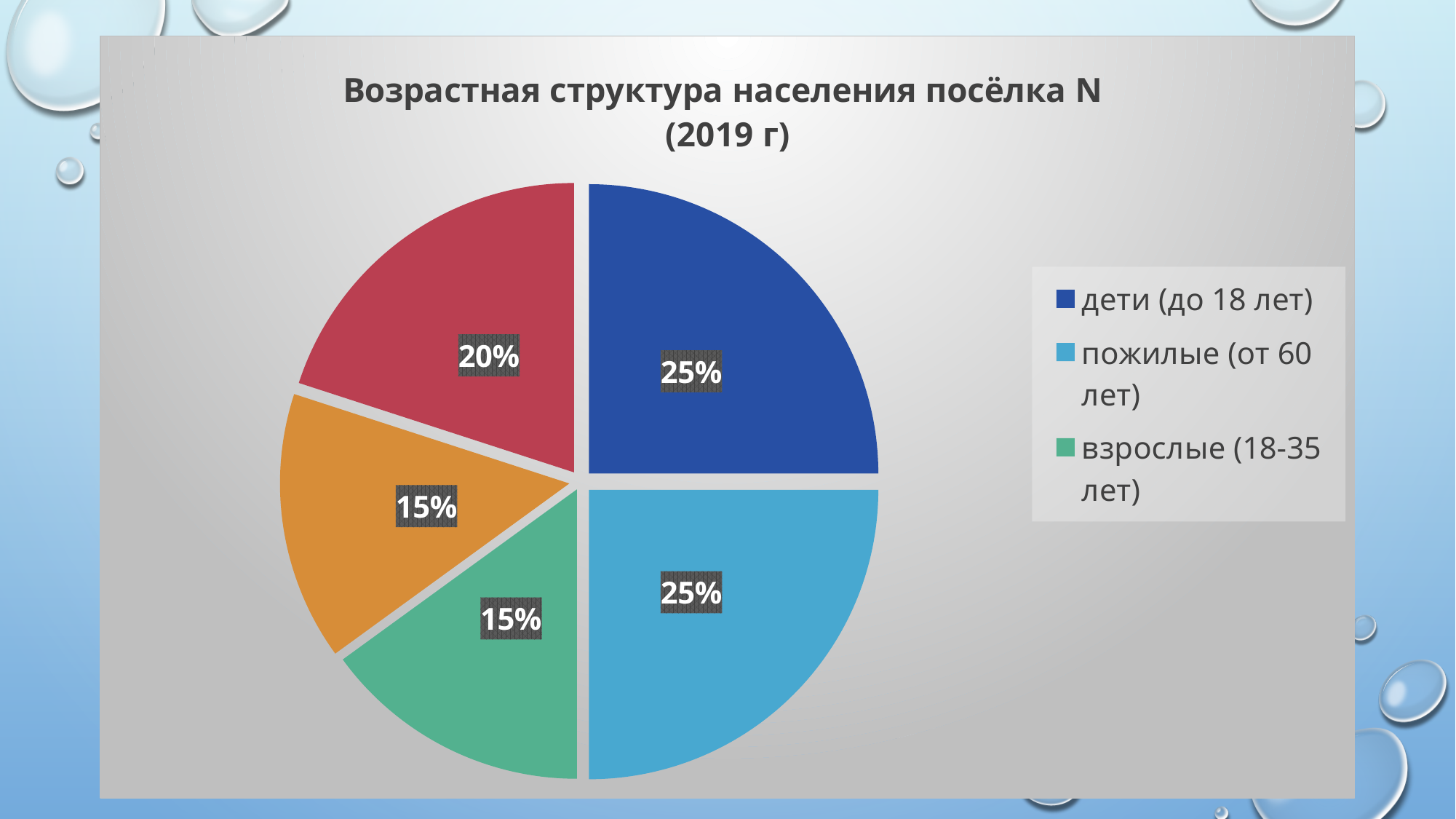
What is the difference between the red slice and the orange slice of the pie? 5% What share of the pie is labelled for взрослые (18-35 лет)? 15% Which is larger: the share for пожилые (от 60 лет) or the share for взрослые (18-35 лет)? пожилые (от 60 лет) How many slices does the pie chart have? 5 What type of chart is shown on the slide? pie chart What is the title of the chart? Возрастная структура населения посёлка N (2019 г) How many entries does the legend list? 3 What share of the pie is labelled for дети (до 18 лет)? 25% What percentage is shown on the red slice of the pie? 20% What is the difference between the share for дети (до 18 лет) and the share for взрослые (18-35 лет)? 10% What share of the pie is labelled for пожилые (от 60 лет)? 25% What percentage is shown on the orange slice of the pie? 15%